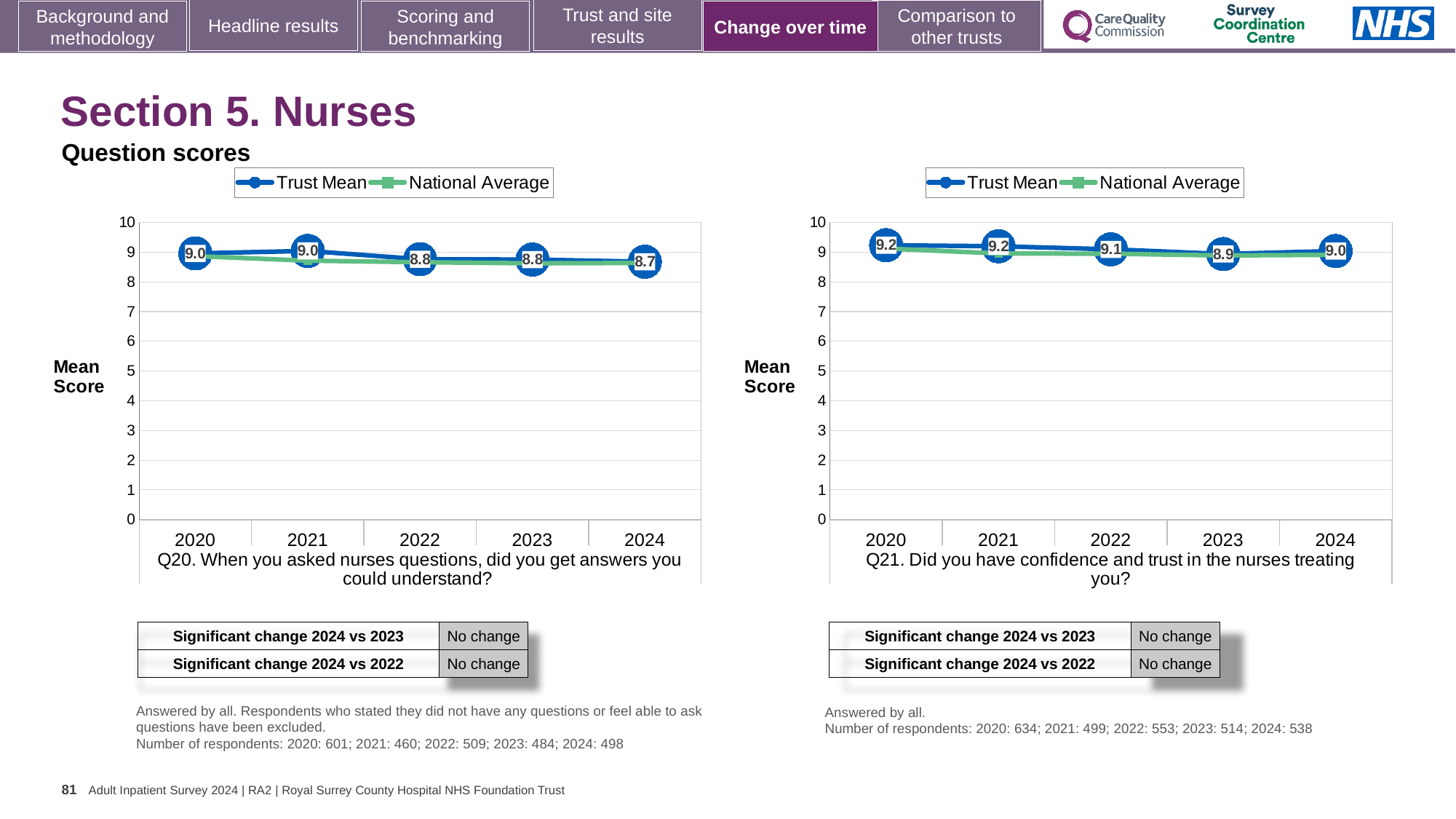
In the Q20 chart (left), what is the Trust Mean score for 2024? 8.7 How many series does the legend of the Q21 chart (right) list? 2 In the Q20 chart (left), what is the difference between the Trust Mean scores for 2020 and 2024? 0.3 In the Q21 chart (right), what is the Trust Mean score for 2023? 8.9 What type of chart is the Q20 chart (left)? line chart In the Q21 chart (right), which year has the lowest Trust Mean score? 2023 In the Q21 chart (right), is the Trust Mean score for 2022 larger or smaller than the score for 2024? larger How many years are plotted on the x axis of the Q20 chart (left)? 5 In the Q20 chart (left), what is the Trust Mean score for 2020? 9.0 In the Q20 chart (left), which year has the lowest Trust Mean score? 2024 In the Q21 chart (right), what is the Trust Mean score for 2020? 9.2 In the Q21 chart (right), does the Trust Mean score generally rise or fall from 2020 to 2024? fall